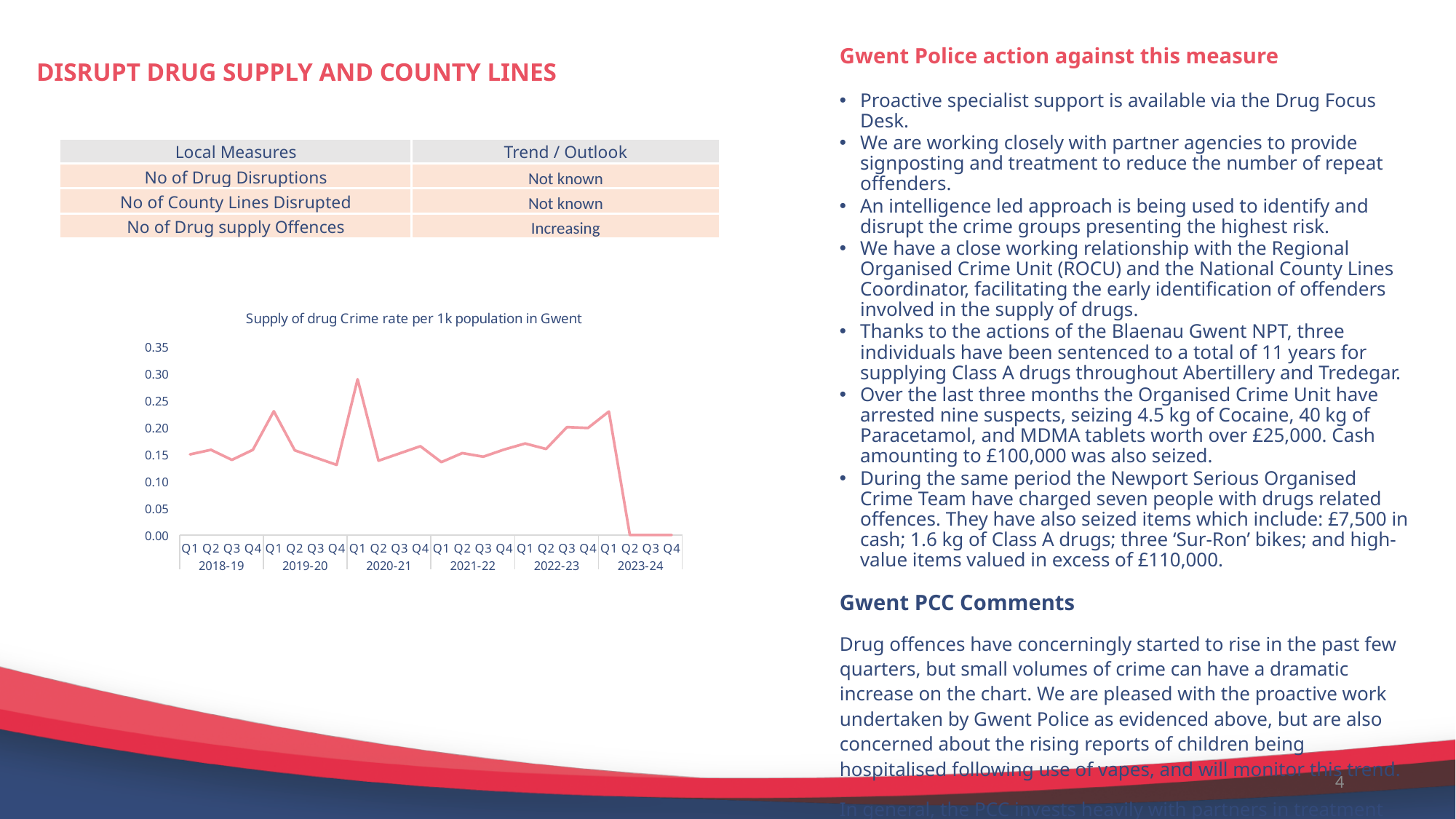
How many quarterly data points are plotted on the chart? 24 What is the highest value shown on the y axis of the chart? 0.35 Is the value for Q1 2018-19 greater or less than 0.20? less What kind of chart is used to show the supply of drug crime rate per 1k population in Gwent? line chart Is the value for Q1 2020-21 greater or less than 0.25? greater Which is larger, the value for Q1 2023-24 or the value for Q2 2023-24? Q1 2023-24 What is the title of the chart on the slide? Supply of drug Crime rate per 1k population in Gwent What value does the line show for Q4 2023-24? 0.00 How many financial years are shown along the x axis of the chart? 6 Is the value for Q1 2019-20 greater or less than 0.20? greater Which is larger, the value for Q1 2020-21 or the value for Q1 2019-20? Q1 2020-21 Which quarter has the highest supply of drug crime rate on the chart? Q1 2020-21